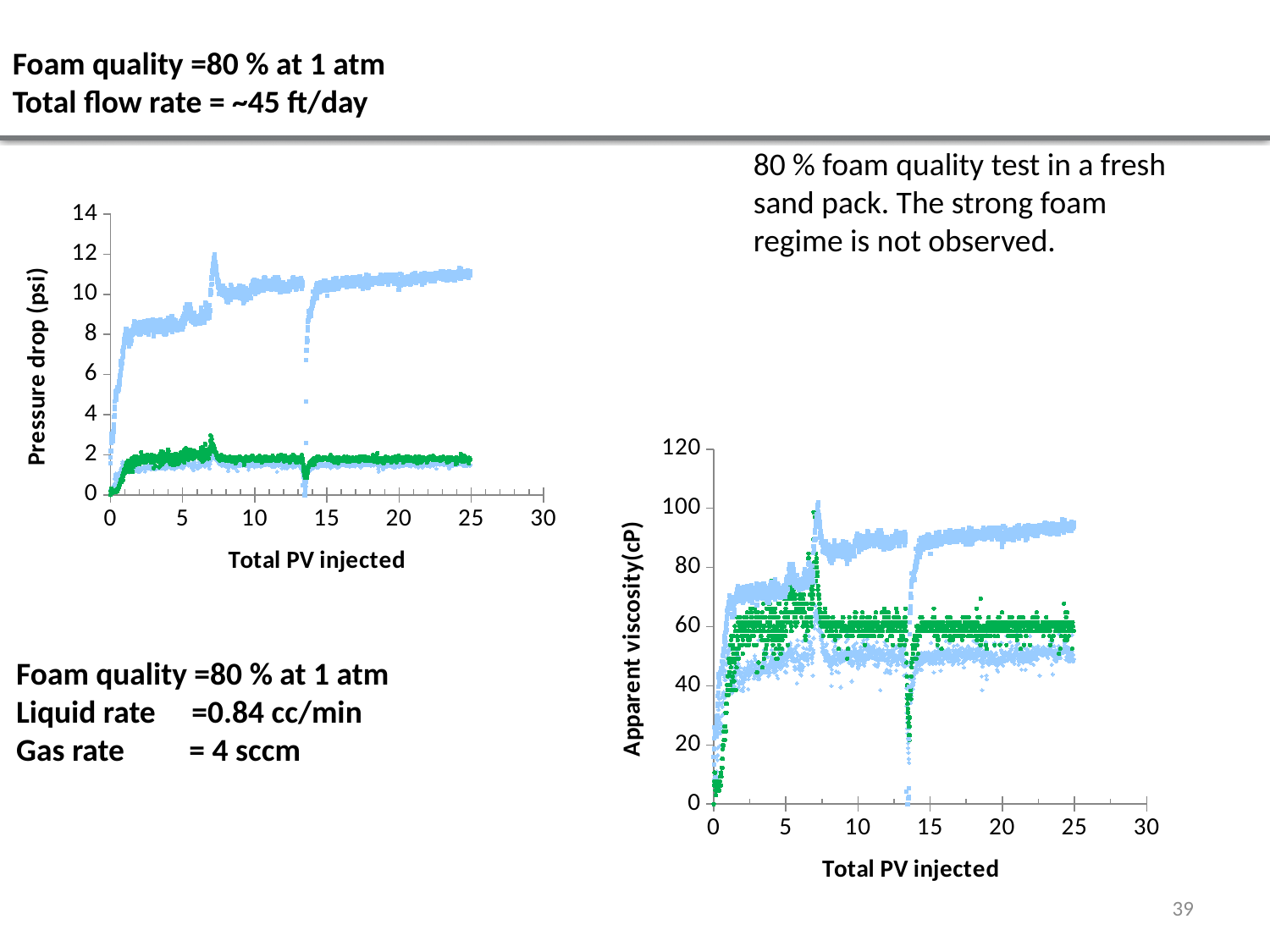
What is the y-axis label of the right chart? Apparent viscosity(cP) In the right chart (Apparent viscosity), is the value of the upper light-blue series at 20 total PV injected greater or less than 80? greater In the right chart (Apparent viscosity), is the value of the green series at 20 total PV injected greater or less than 40? greater What is the x-axis label of the left chart? Total PV injected What kind of chart is the chart on the left of the slide (Pressure drop vs Total PV injected)? scatter chart In the right chart (Apparent viscosity), does the upper light-blue series overall rise or fall from 0 to 25 total PV injected? rise What kind of chart is the chart on the right of the slide (Apparent viscosity vs Total PV injected)? scatter chart In the left chart (Pressure drop), is the value of the upper light-blue series at 5 total PV injected greater or less than 6? greater In the left chart (Pressure drop), which series is higher at 20 total PV injected, the upper light-blue series or the green series? the upper light-blue series